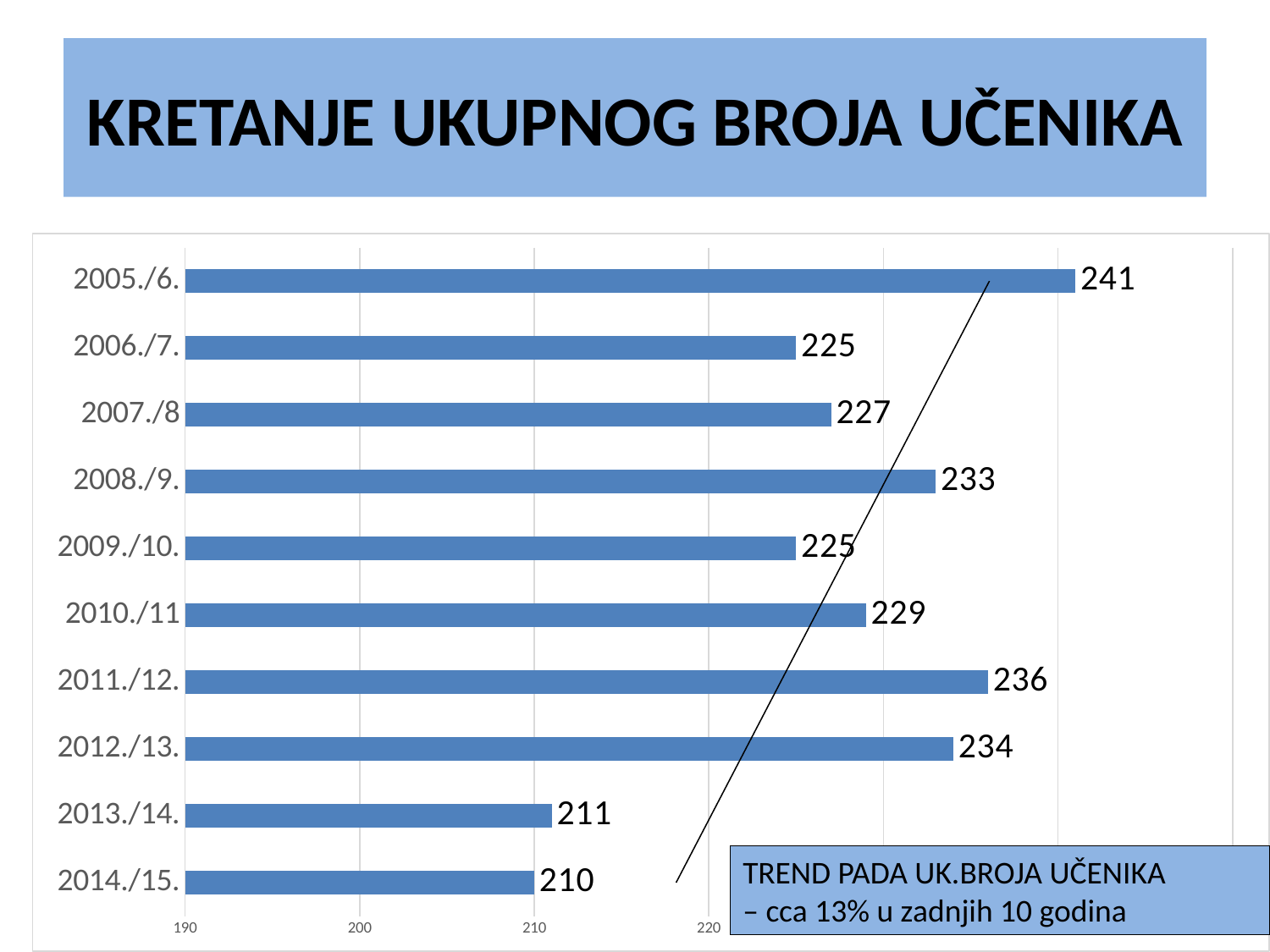
What is the difference between the values for 2005./6. and 2014./15.? 31 What kind of chart is shown on the slide? bar chart What is the title of the slide? KRETANJE UKUPNOG BROJA UČENIKA Which school year has the lowest value? 2014./15. How many school years are shown in the chart? 10 What is the value for 2005./6.? 241 What is the difference between the values for 2012./13. and 2013./14.? 23 What is the value for 2014./15.? 210 Is the value for 2013./14. greater or less than 220? less Which is larger, the value for 2008./9. or the value for 2010./11.? 2008./9. Which school year has the highest value? 2005./6. What is the value for 2011./12.? 236